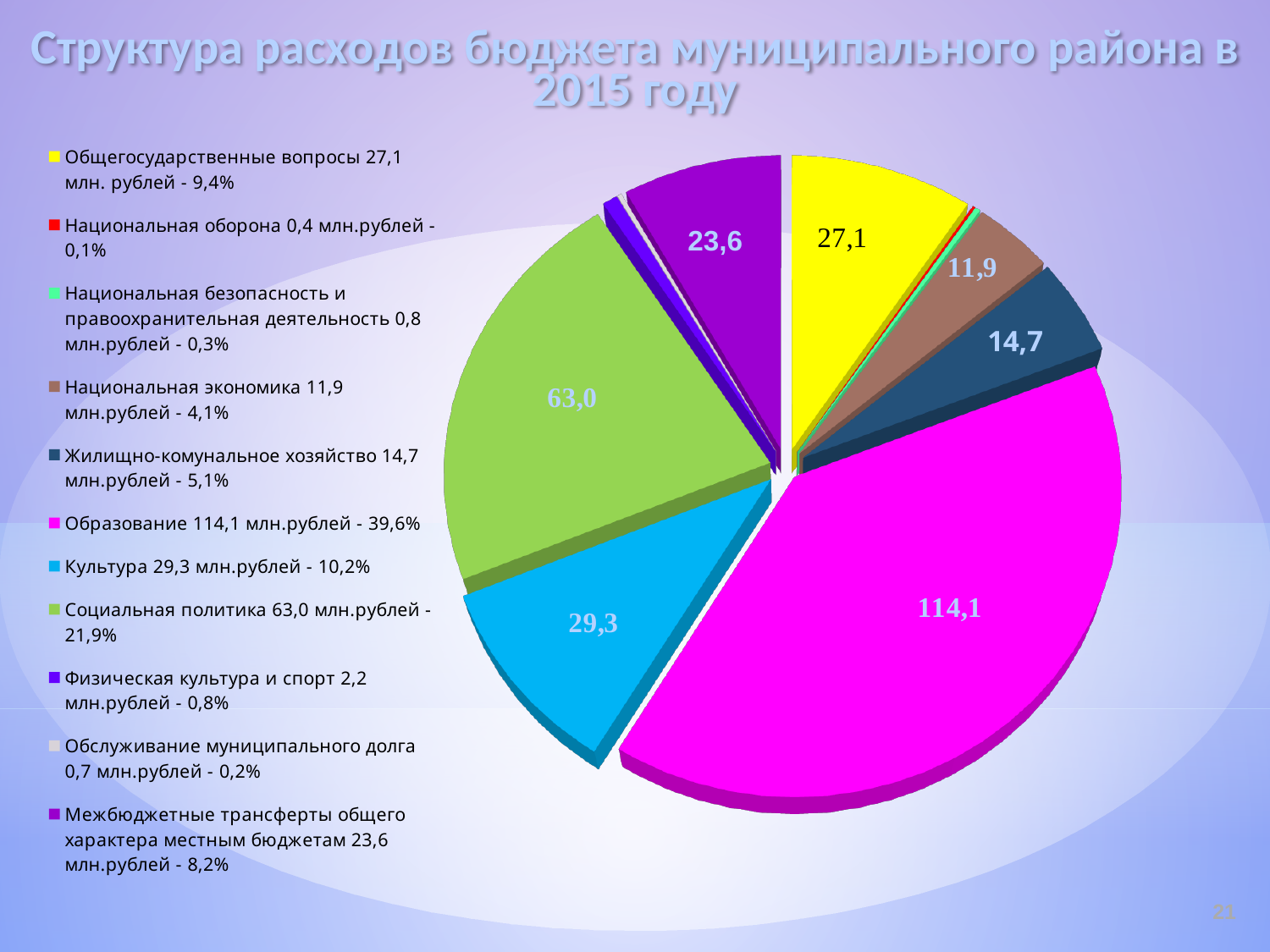
Which category has the smallest share according to the legend? Национальная оборона How many categories does the legend of the pie chart list? 11 What value is shown for Образование on the pie chart? 114,1 Which category has the largest slice of the pie chart? Образование What share of the pie does Образование represent, according to the legend? 39,6% What value is shown for Культура on the pie chart? 29,3 What is the title of the chart on the slide? Структура расходов бюджета муниципального района в 2015 году What share of the pie does Социальная политика represent, according to the legend? 21,9% What kind of chart is shown on the slide? pie chart What is the difference between the values for Образование and Социальная политика? 51,1 Which is larger: the value for Общегосударственные вопросы or the value for Межбюджетные трансферты общего характера местным бюджетам? Общегосударственные вопросы What value is shown for Социальная политика on the pie chart? 63,0